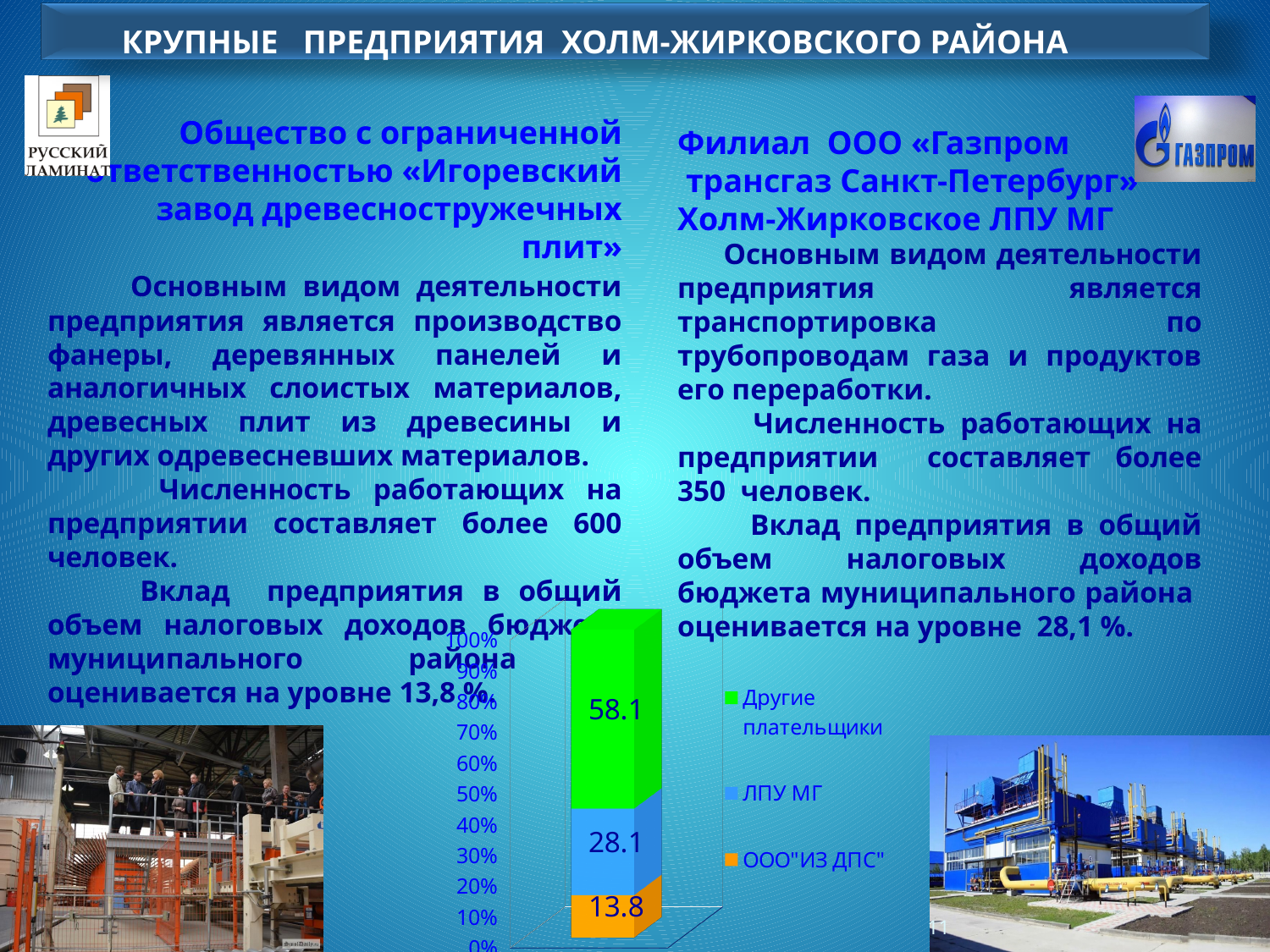
What kind of chart is shown on the slide? stacked bar chart What is the difference between the "ЛПУ МГ" value and the "ООО"ИЗ ДПС"" value? 14.3 What is the total of the three segments in the stacked bar? 100 What value is shown for the "ЛПУ МГ" segment of the bar? 28.1 How many series does the chart legend list? 3 Which is larger, the "ЛПУ МГ" segment or the "ООО"ИЗ ДПС"" segment? ЛПУ МГ What colour is the "ЛПУ МГ" segment in the chart? blue Which legend entry has the largest segment in the bar? Другие плательщики What is the difference between the "Другие плательщики" value and the "ЛПУ МГ" value? 30 Which legend entry has the smallest segment in the bar? ООО"ИЗ ДПС" What value is shown for the "ООО"ИЗ ДПС"" segment of the bar? 13.8 What value is shown for the "Другие плательщики" segment of the bar? 58.1